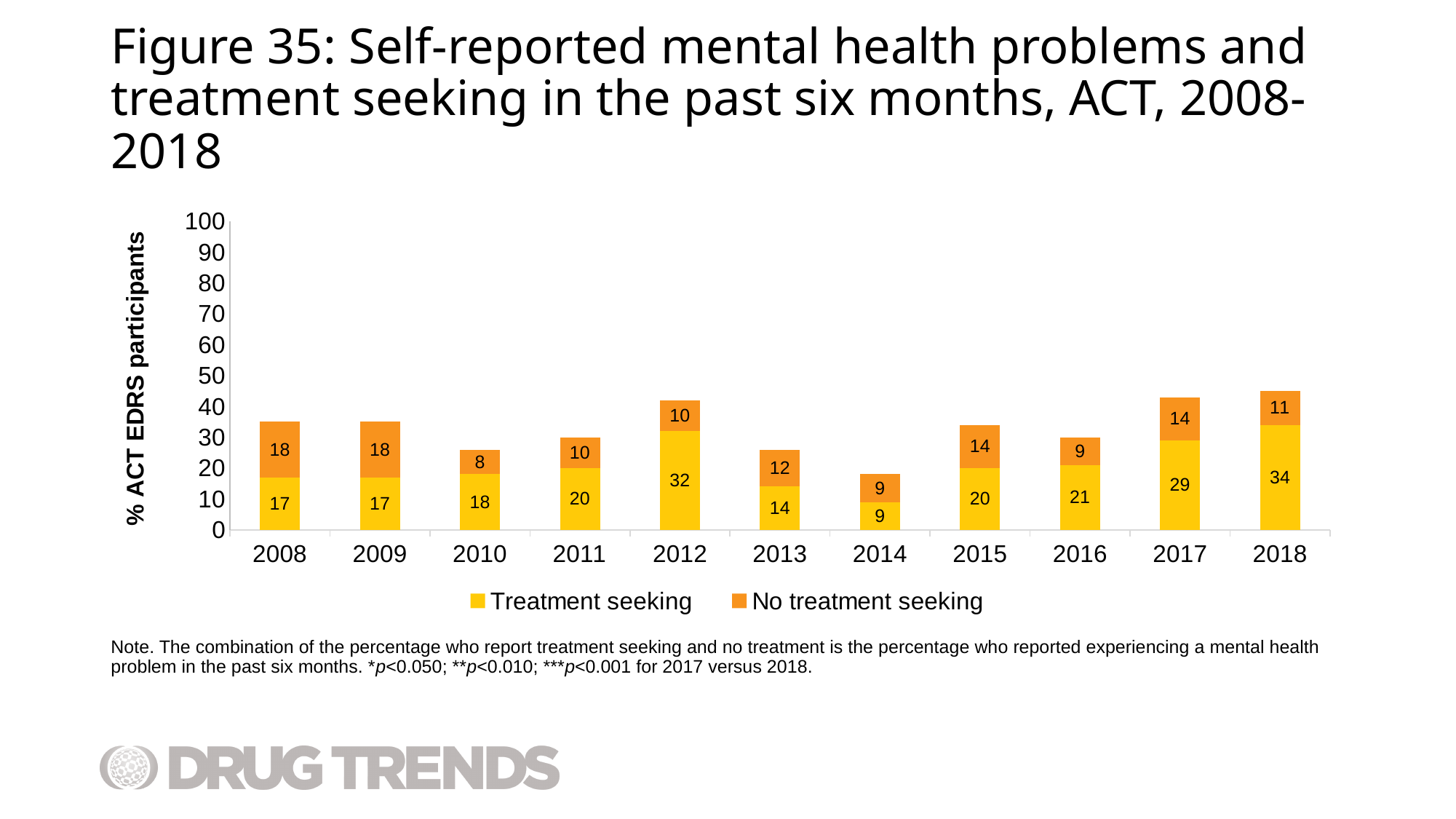
Which year has the lowest No treatment seeking value? 2010 Which year has the highest Treatment seeking value? 2018 Which is larger, the No treatment seeking value for 2008 or for 2013? 2008 What is the Treatment seeking value for 2012? 32 What is the total of the stacked bar for 2012? 42 How many years are shown on the x axis? 11 How many series does the legend list? 2 What is the difference between the Treatment seeking values for 2018 and 2017? 5 What kind of chart is shown? Stacked bar chart What is the total of the stacked bar for 2014? 18 What is the No treatment seeking value for 2017? 14 What is the Treatment seeking value for 2014? 9